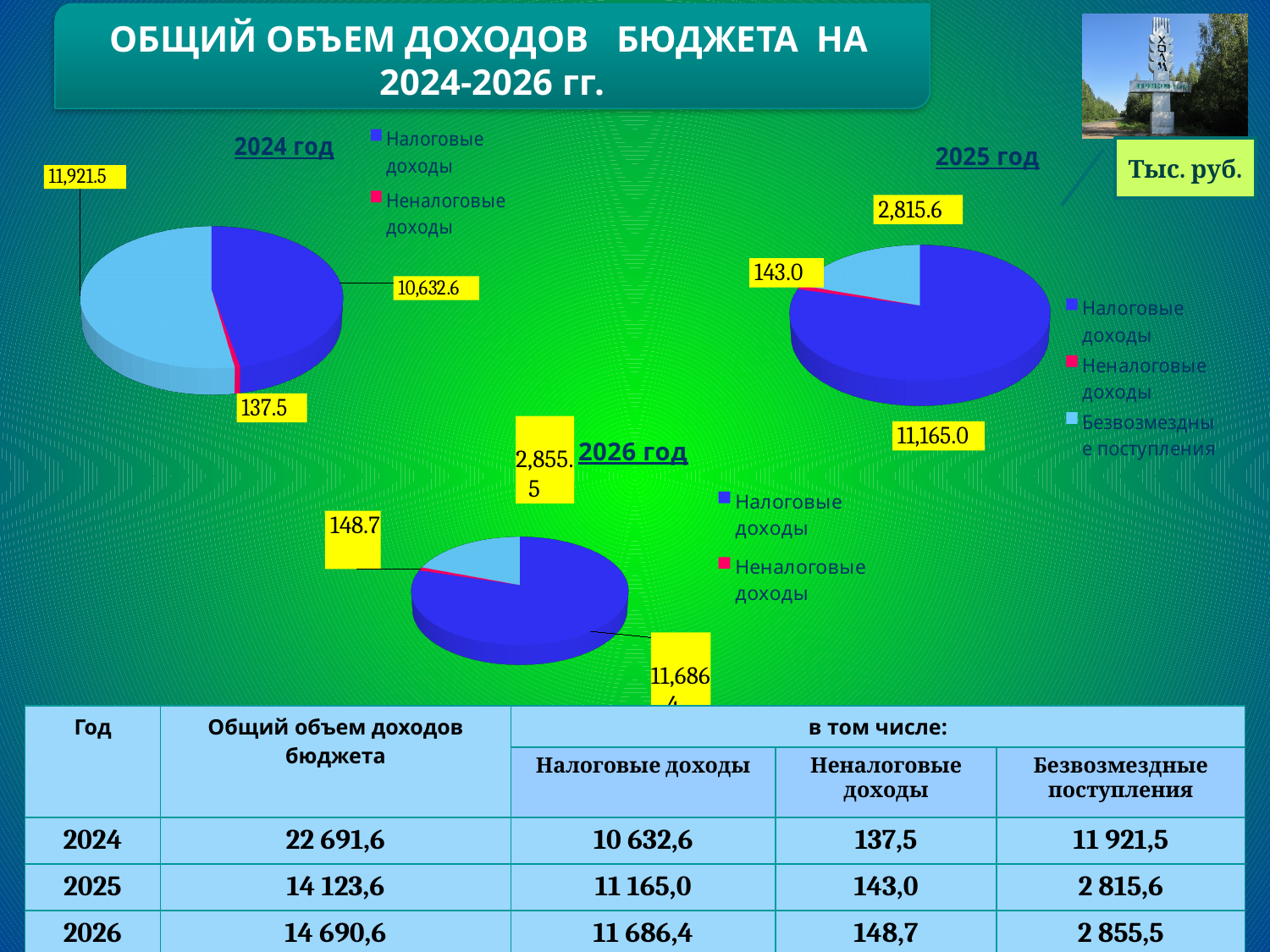
Which is larger: Неналоговые доходы in the 2026 год chart or Неналоговые доходы in the 2025 год chart? 2026 год (148.7) In the 2024 год chart, which slice is the largest? Безвозмездные поступления (11,921.5) In the 2024 год chart, what is the difference between the 11,921.5 slice and the 10,632.6 slice? 1,288.9 In the 2024 год chart, what is the value for Неналоговые доходы? 137.5 How many entries does the legend of the 2025 год chart list? 3 In the 2026 год chart, what is the value for Неналоговые доходы? 148.7 What kind of chart is used for the 2024 год chart? pie chart How many pie charts are shown on the slide? 3 In the 2024 год chart, what is the value for Налоговые доходы? 10,632.6 In the 2025 год chart, what is the value for Налоговые доходы? 11,165.0 In the 2025 год chart, what is the value for Безвозмездные поступления? 2,815.6 In the 2025 год chart, which slice is the smallest? Неналоговые доходы (143.0)